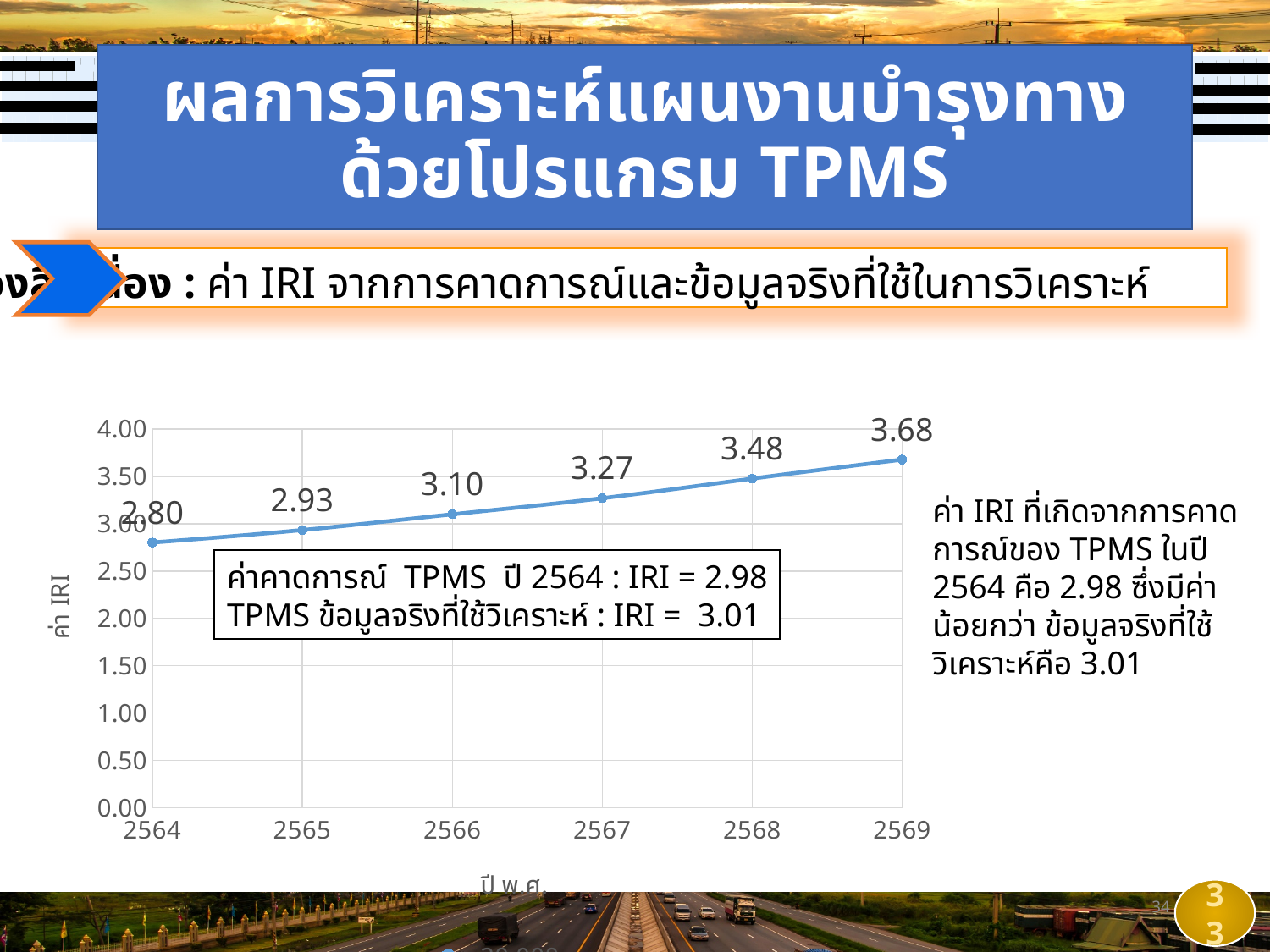
Do the IRI values rise or fall from 2564 to 2569? rise Which year has the lowest IRI value? 2564 What is the label of the y axis? ค่า IRI What is the difference between the IRI values for 2569 and 2564? 0.88 What is the IRI value for the year 2566? 3.10 What type of chart is shown on the slide? line chart How many years are plotted on the x axis? 6 Which year has the highest IRI value? 2569 What is the IRI value for the year 2564? 2.80 What is the IRI value for the year 2568? 3.48 What is the difference between the IRI values for 2567 and 2566? 0.17 Which year has a larger IRI value, 2565 or 2567? 2567